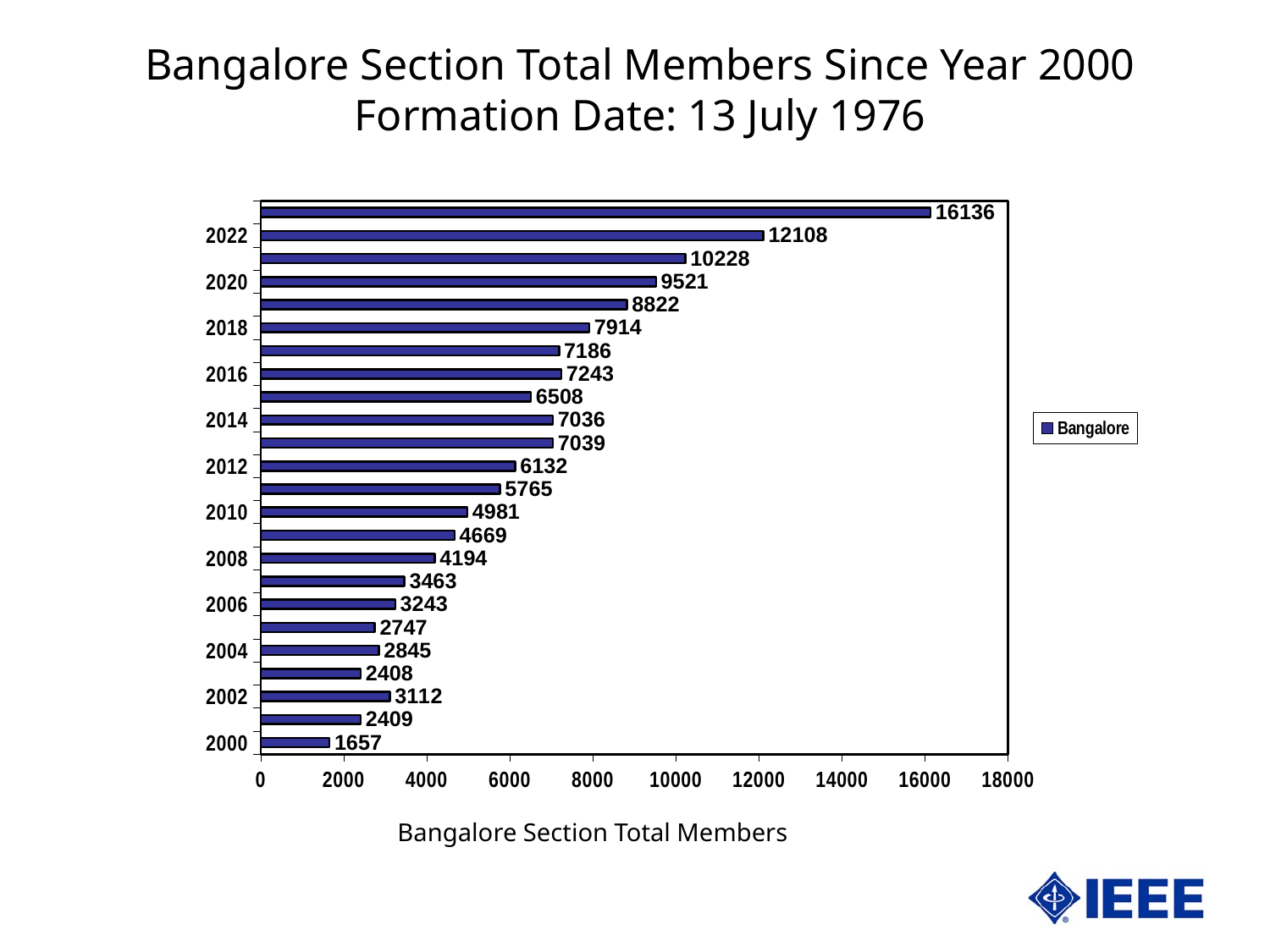
What kind of chart is shown? bar chart What is the difference between the values for 2022 and 2020? 2587 What is the value for 2022? 12108 How many series does the legend list? 1 What is the value for 2016? 7243 What is the value for 2010? 4981 Which is larger, the value for 2012 or the value for 2014? 2014 Is the value for 2018 greater or less than 8000? less Which year has the lowest value? 2000 What is the value for 2000? 1657 What series name is shown in the legend? Bangalore How many bars are plotted in the chart? 24